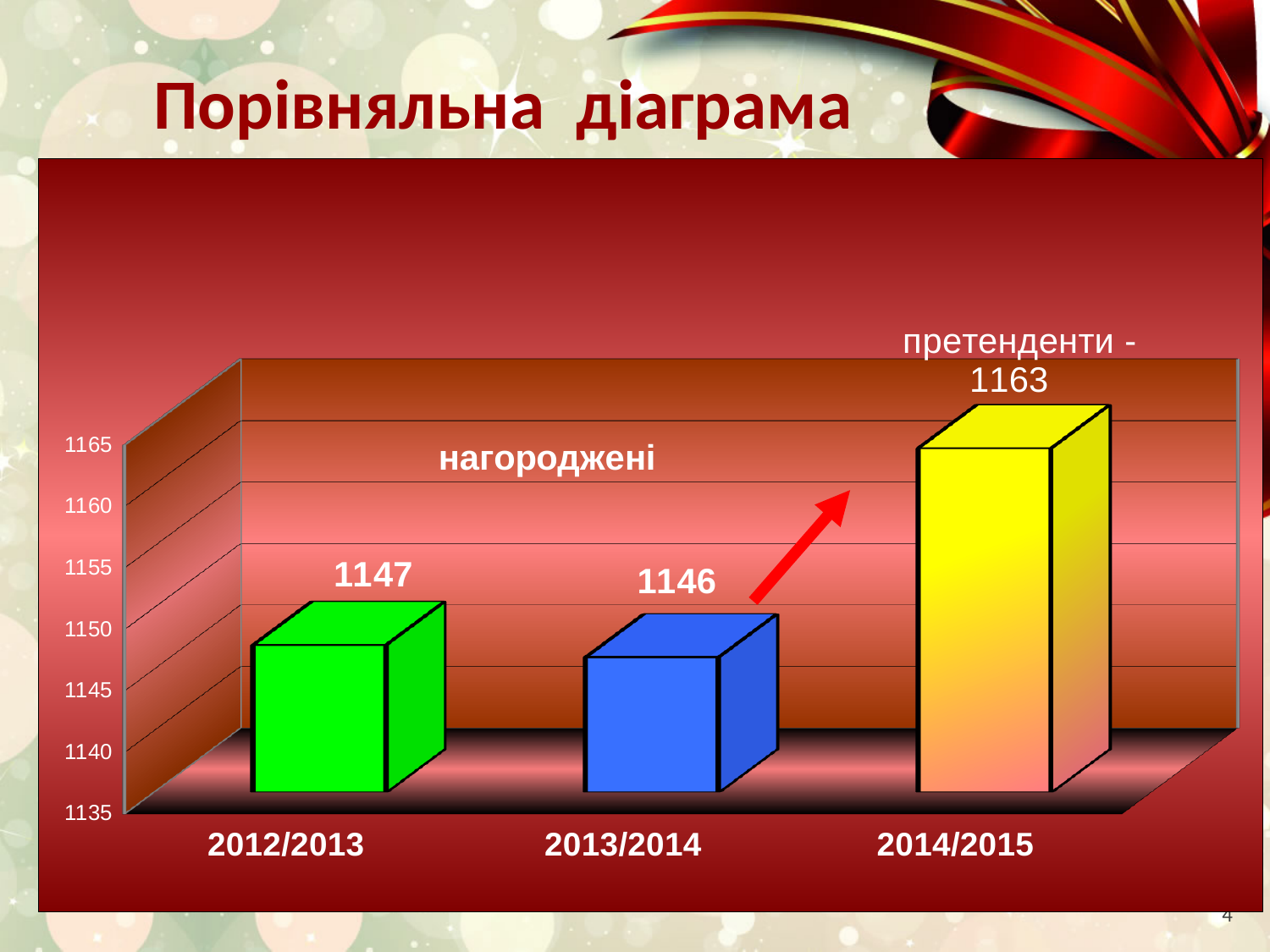
What is the value for 2012/2013? 1147 What kind of chart is shown on the slide? bar chart Which is larger, the value for 2012/2013 or the value for 2013/2014? 2012/2013 What is the value for 2014/2015? 1163 Which category has the lowest value? 2013/2014 Which category has the highest value? 2014/2015 What is the value for 2013/2014? 1146 What is the difference between the values for 2014/2015 and 2013/2014? 17 What is the difference between the values for 2012/2013 and 2013/2014? 1 Is the value for 2014/2015 greater or less than 1160? greater What is the title of the slide? Порівняльна діаграма How many categories are shown on the x axis? 3